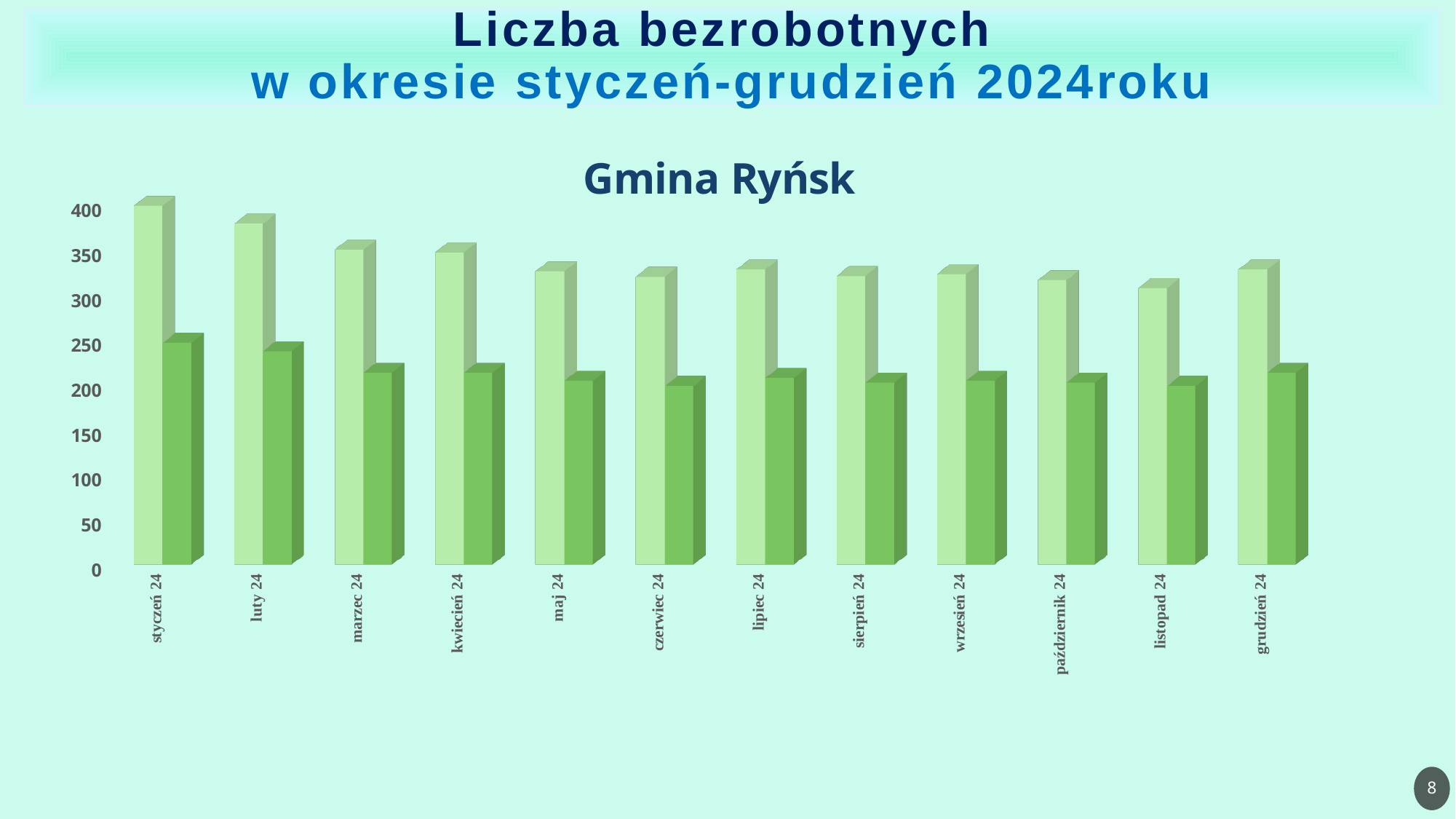
Which month has the tallest darker green bar? styczeń 24 Is the lighter green bar for listopad 24 greater or less than 350? less What is the title printed above the chart? Gmina Ryńsk Do the lighter green bars generally rise or fall from styczeń 24 to grudzień 24? fall Which month has the tallest lighter green bar? styczeń 24 How many months (categories) are shown on the x axis of the chart? 12 Which month has the shortest lighter green bar? listopad 24 What kind of chart is shown on the slide? bar chart Is the darker green bar for czerwiec 24 greater or less than 250? less Is the lighter green bar for styczeń 24 greater or less than 350? greater Which is larger, the darker green bar for luty 24 or the darker green bar for marzec 24? luty 24